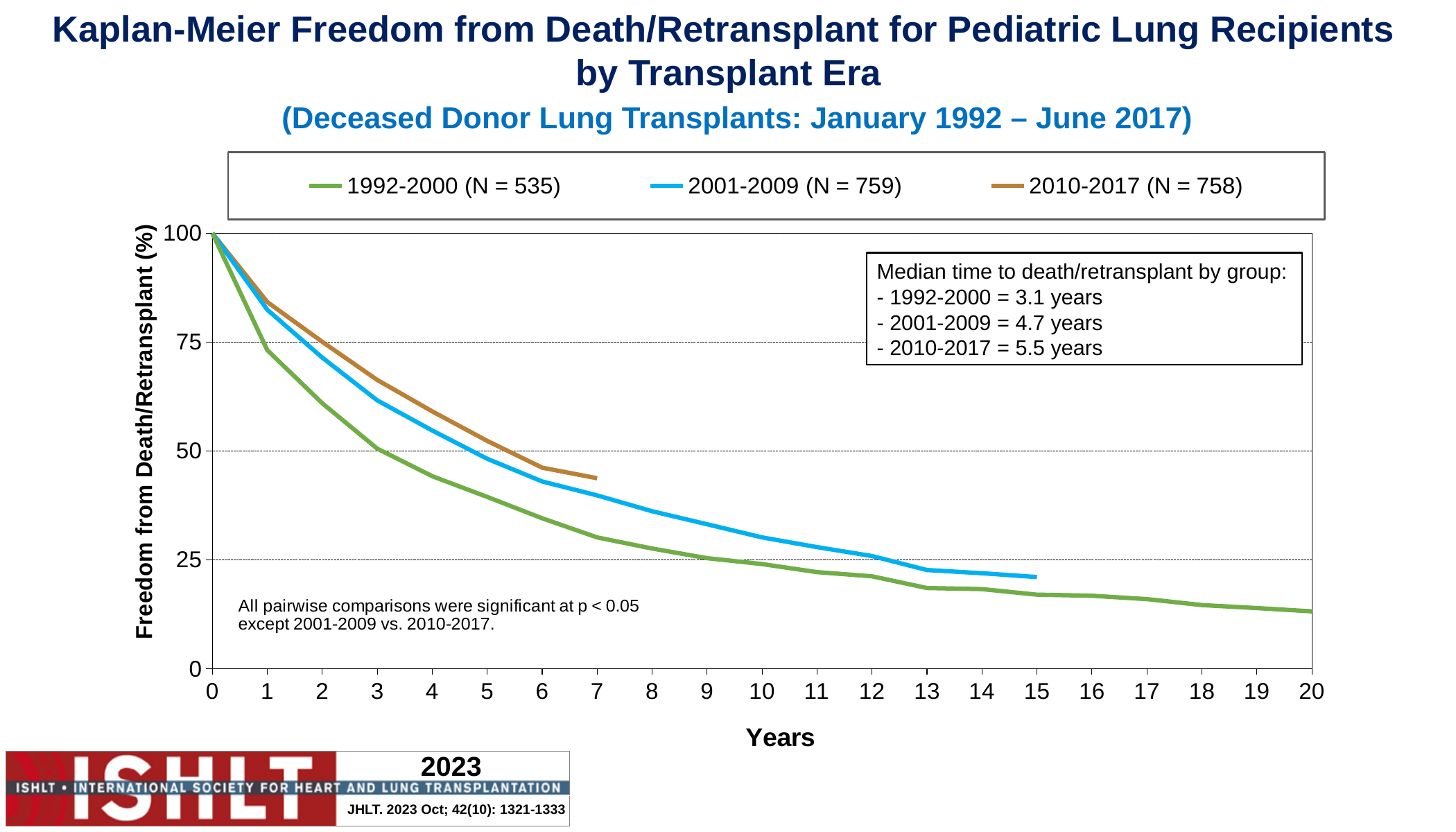
According to the legend, what is the N for the 2001-2009 group? 759 Is the value for the 1992-2000 group at 20 years greater or less than 25? less At 5 years, which group has the higher freedom from death/retransplant: 1992-2000 or 2001-2009? 2001-2009 What kind of chart is shown on the slide? line chart What is the median time to death/retransplant for the 1992-2000 group? 3.1 years Do the curves rise or fall as years increase? fall What is the median time to death/retransplant for the 2010-2017 group? 5.5 years Which group has the longest median time to death/retransplant? 2010-2017 Is the value for the 1992-2000 group at 5 years greater or less than 50? less How many series does the legend list? 3 What is the difference between the median time to death/retransplant for the 2010-2017 group and the 1992-2000 group? 2.4 years Is the value for the 2010-2017 group at 3 years greater or less than 50? greater